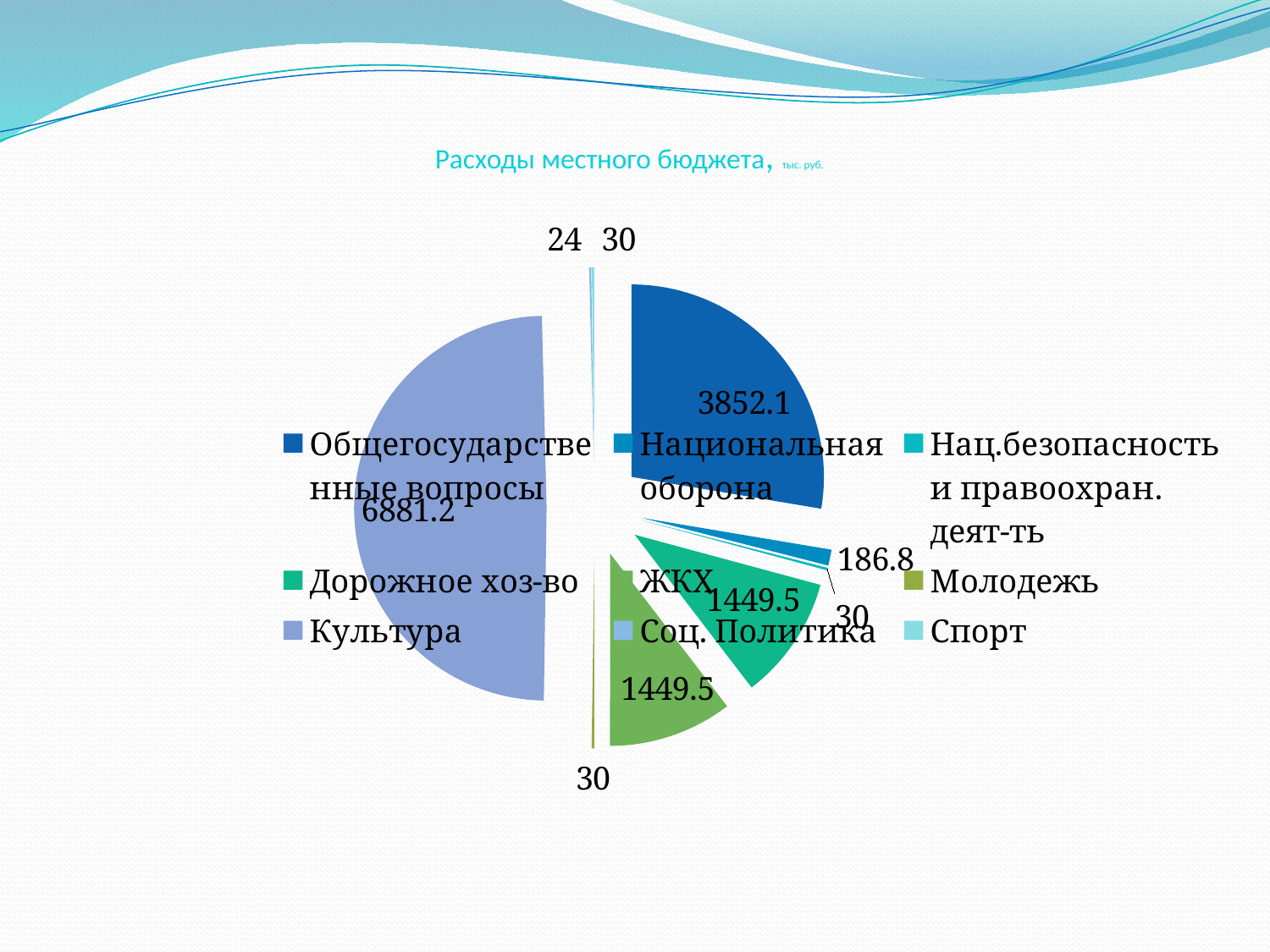
What is the difference between the values for Культура and Общегосударственные вопросы? 3029.1 What is the value for Общегосударственные вопросы? 3852.1 What is the value for Нац.безопасность и правоохран. деят-ть? 30 Which is larger, the value for Общегосударственные вопросы or the value for Дорожное хоз-во? Общегосударственные вопросы What is the value for ЖКХ? 1449.5 What is the value for Дорожное хоз-во? 1449.5 What is the title of the chart? Расходы местного бюджета, тыс. руб. How many categories does the legend of the pie chart list? 9 What kind of chart is shown on the slide? pie chart What is the difference between the values for Дорожное хоз-во and Нац.безопасность и правоохран. деят-ть? 1419.5 What is the value for Культура? 6881.2 Which category has the largest slice of the pie? Культура